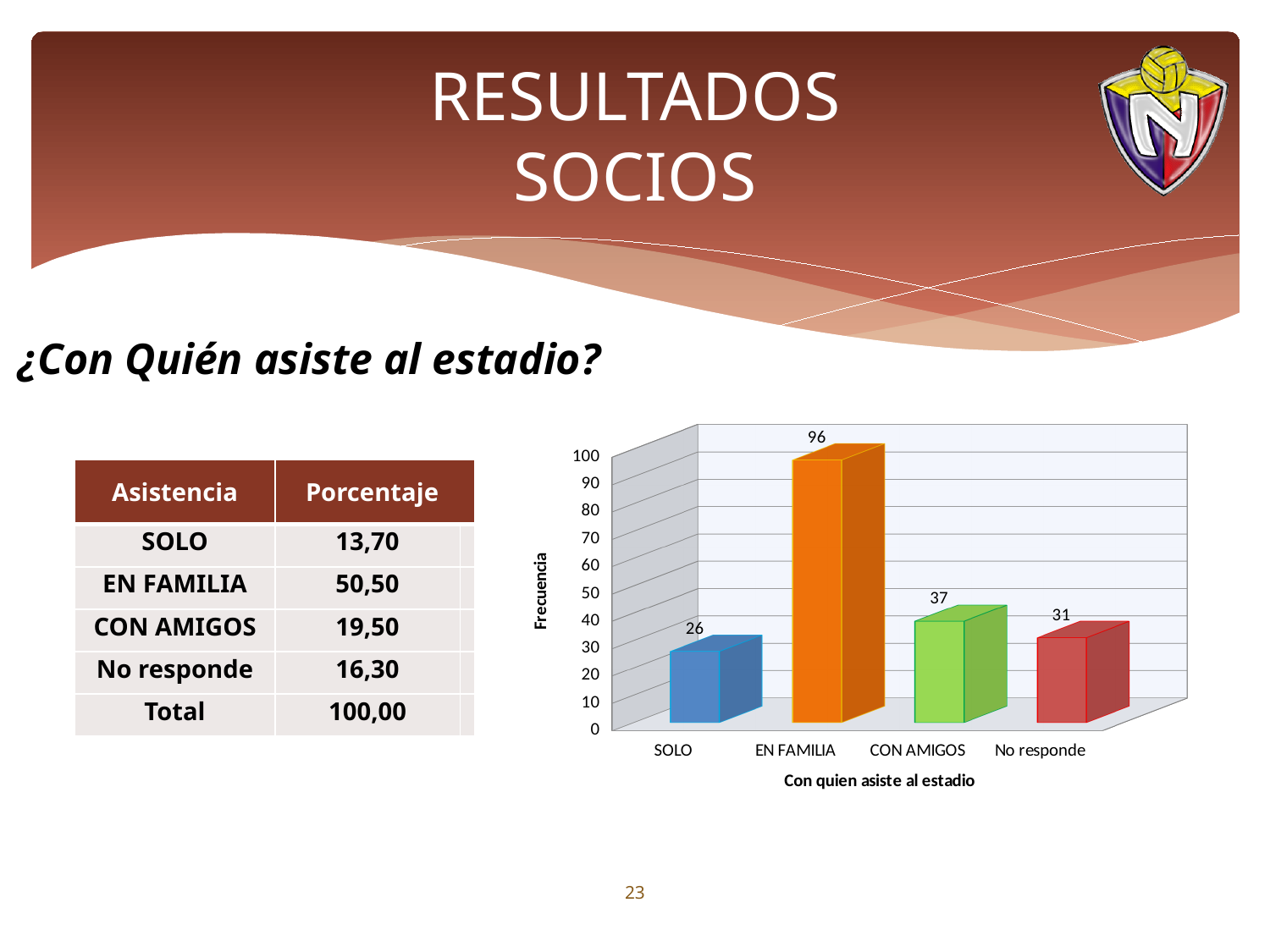
Which has a larger frequency, CON AMIGOS or No responde? CON AMIGOS What is the frequency value for No responde in the chart? 31 What is the difference between the frequency for EN FAMILIA and the frequency for CON AMIGOS? 59 How many categories are shown on the x axis of the chart? 4 What is the frequency value for SOLO in the chart? 26 What is the frequency value for EN FAMILIA in the chart? 96 What is the difference between the frequency for CON AMIGOS and the frequency for No responde? 6 What kind of chart is shown on the slide? Bar chart What is the label of the vertical axis of the chart? Frecuencia Which category has the highest frequency in the chart? EN FAMILIA Which category has the lowest frequency in the chart? SOLO What is the frequency value for CON AMIGOS in the chart? 37